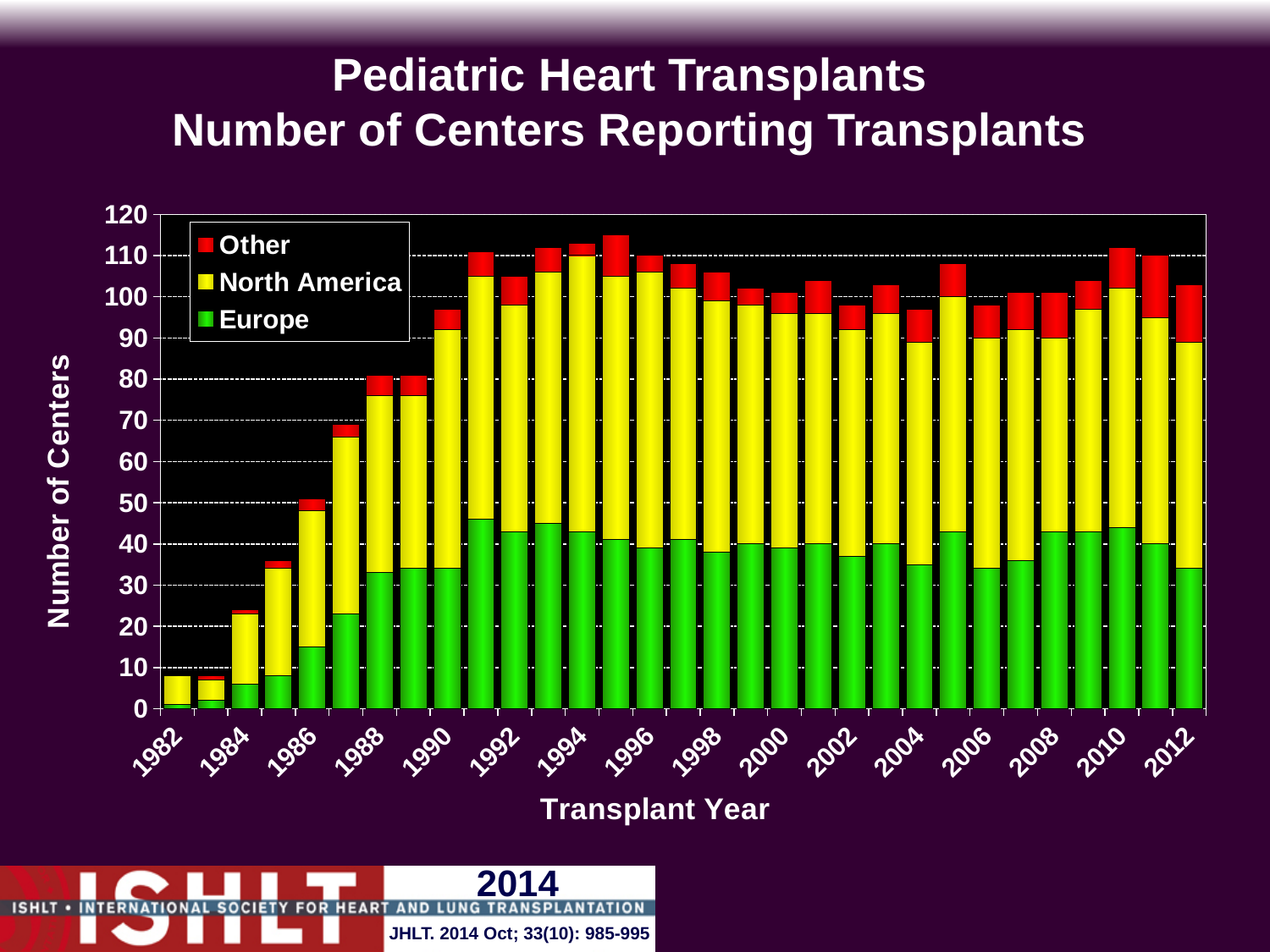
How many series does the legend list? 3 Is the total number of centers for 1995 greater or less than 110? greater Is the total number of centers for 1990 greater or less than 90? greater Is the total number of centers for 2005 greater or less than 100? greater Which series are listed in the legend? Other, North America, Europe How many transplant years (bars) are plotted in the chart? 31 What kind of chart is shown on the slide? stacked bar chart Does the total number of centers rise or fall from 1982 to 1991? rise